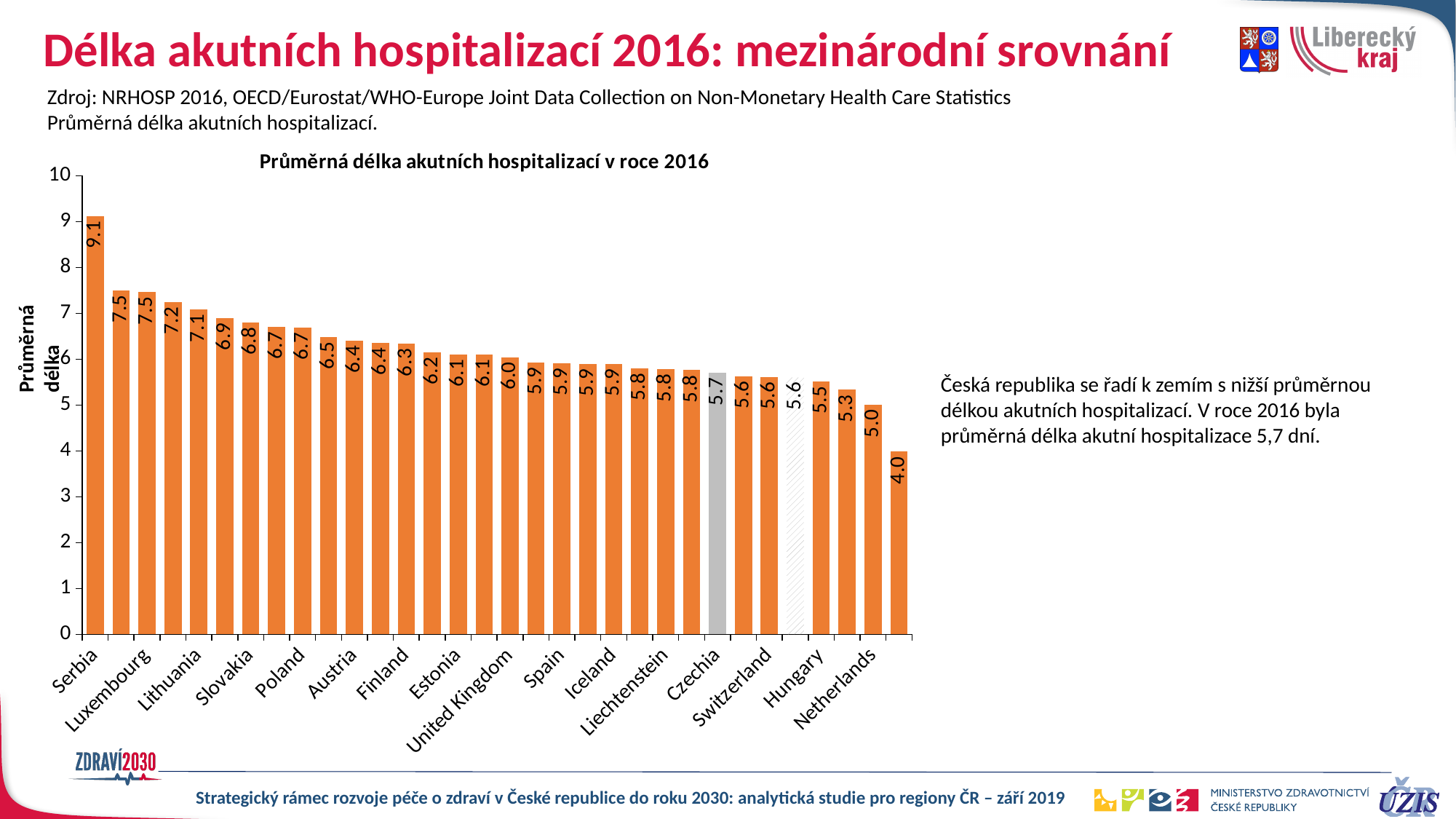
What kind of chart is shown on the slide? bar chart Do the values rise or fall from left to right along the x axis? fall Which country's bar is coloured grey instead of orange? Czechia What value is shown for Czechia? 5.7 What value is shown for Hungary? 5.5 What is the lowest value shown on the chart? 4.0 What value is shown for the Netherlands? 5.0 What is the average length of acute hospitalisation shown for Serbia? 9.1 Is the value for Serbia greater or less than 8? greater Which has a higher value, Luxembourg or Hungary? Luxembourg What is the difference between the values for Serbia and Czechia? 3.4 Which country has the highest average length of acute hospitalisation? Serbia